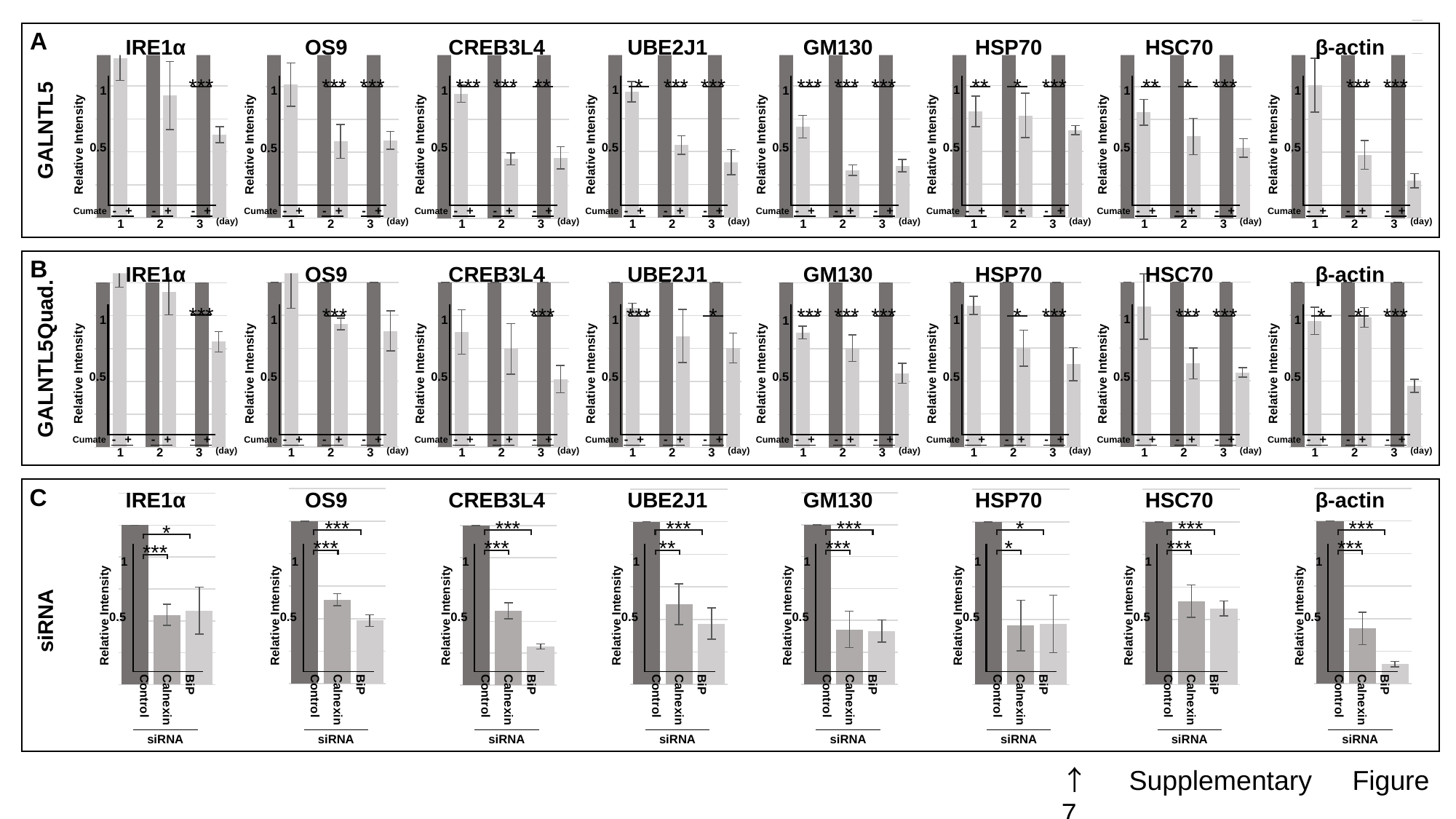
In panel A (GALNTL5), the HSP70 chart: is the Cumate + value on day 1 greater or less than 0.5? greater In panel A (GALNTL5), the GM130 chart: is the Cumate + value on day 2 greater or less than 0.5? less In panel C (siRNA), how many bars does the CREB3L4 chart show? 3 In panel C (siRNA), the β-actin chart: which bar is lowest? BiP In panel C (siRNA), the CREB3L4 chart: which is larger, Calnexin or BiP? Calnexin How many individual charts are in panel A (GALNTL5)? 8 In panel C (siRNA), what kind of chart is the β-actin chart? bar chart What is the y-axis label on the charts in panel B? Relative Intensity In panel C (siRNA), the β-actin chart: is the value for BiP greater or less than 0.5? less